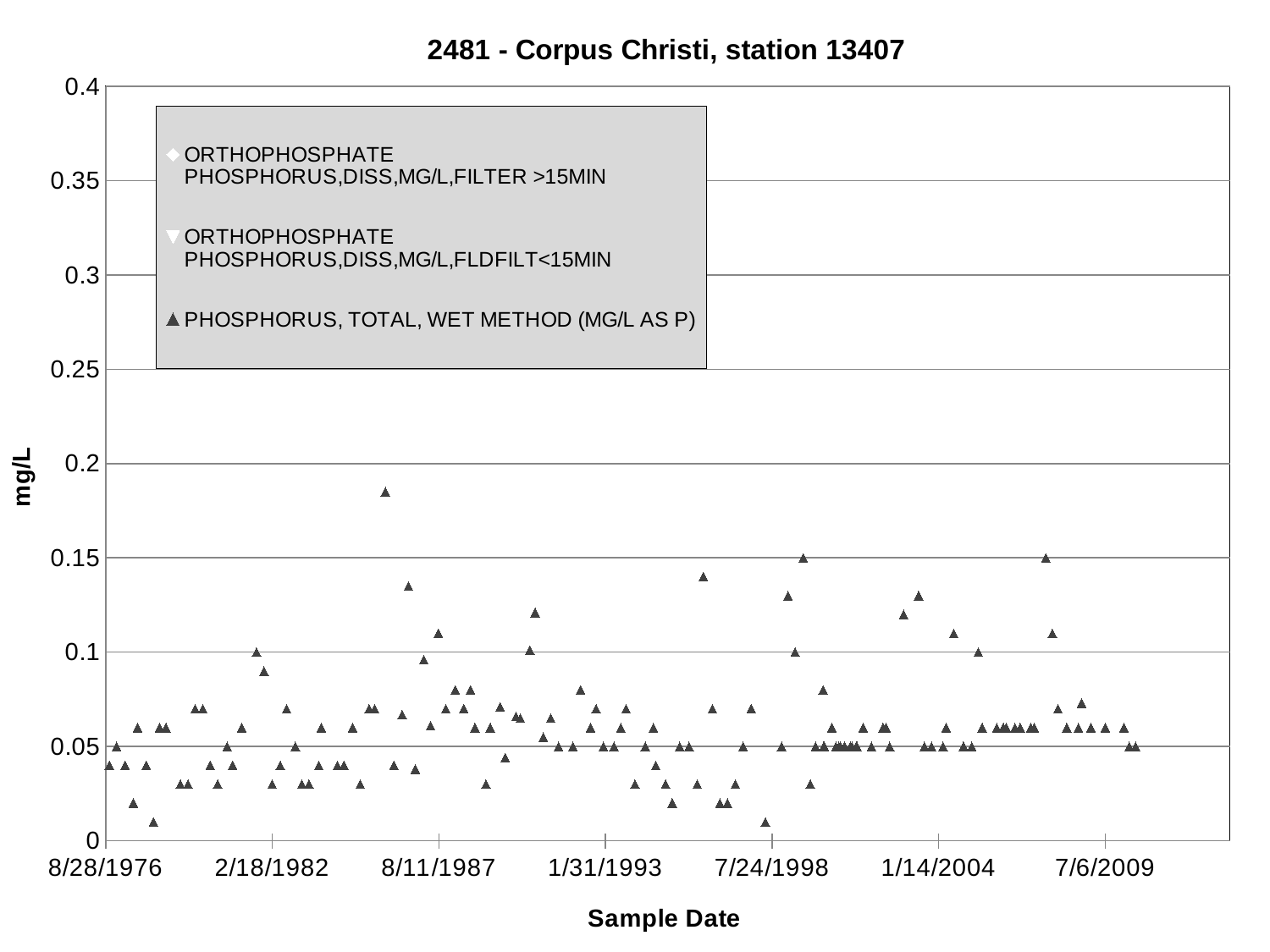
What is the highest value shown on the y axis? 0.4 Is the lowest plotted value on the chart greater or less than 0.05? less How many series does the legend list? 3 What kind of chart is shown on the slide? Scatter chart What is the label on the y axis of the chart? mg/L What is the last date label shown on the x axis? 7/6/2009 Is the highest plotted value on the chart greater or less than 0.2? less What is the first date label shown on the x axis? 8/28/1976 What is the title of the chart? 2481 - Corpus Christi, station 13407 Is the highest plotted value on the chart greater or less than 0.15? greater How many date labels are shown along the x axis? 7